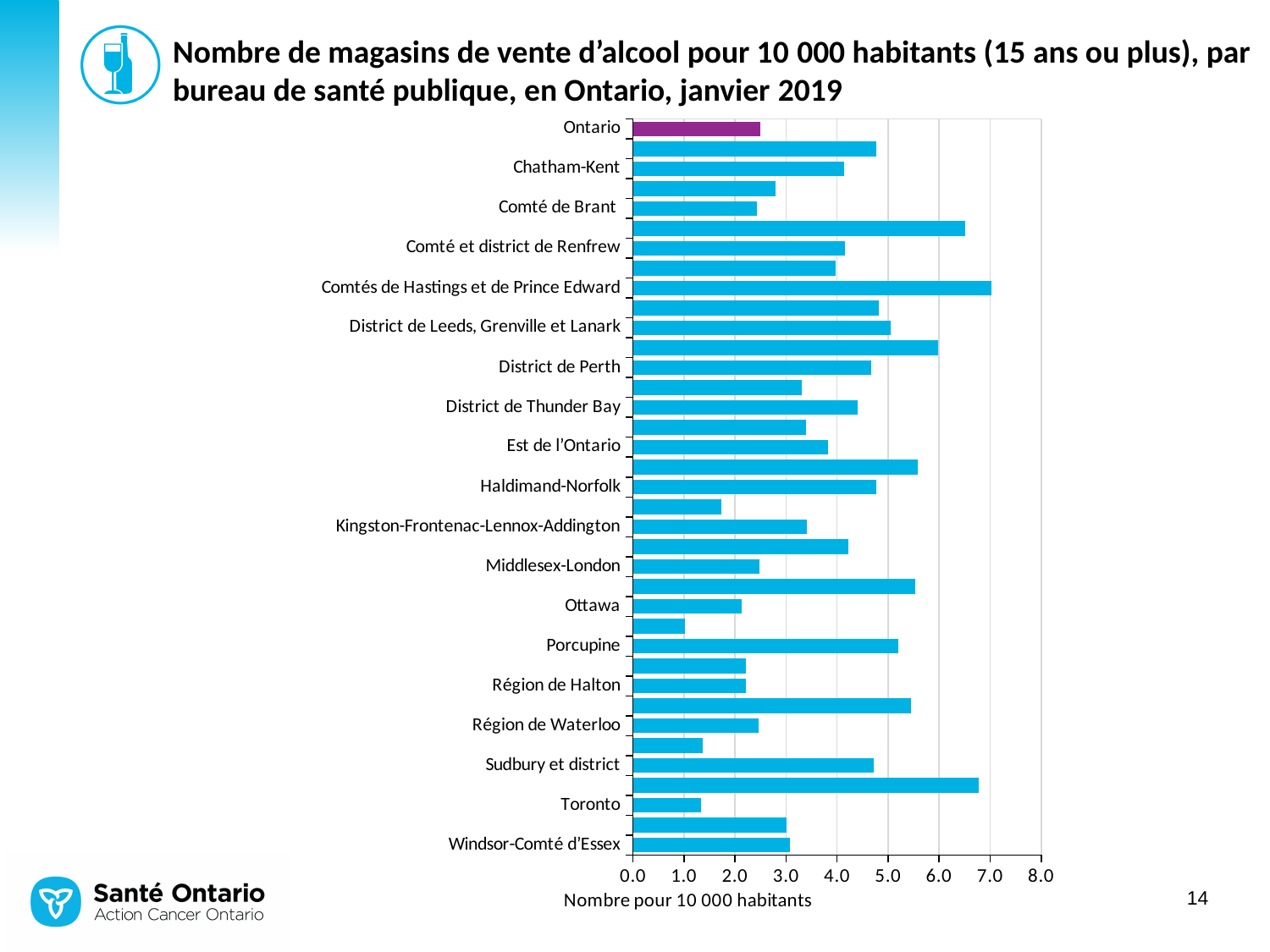
Is the value for Ottawa greater or less than 3.0? less Which has the larger value, Comtés de Hastings et de Prince Edward or Toronto? Comtés de Hastings et de Prince Edward What is the title of the horizontal axis? Nombre pour 10 000 habitants Is the value for Comtés de Hastings et de Prince Edward greater or less than 6.0? greater Is the value for Toronto greater or less than 2.0? less Among the labelled public health units, which has the highest value? Comtés de Hastings et de Prince Edward What kind of chart is shown on the slide? bar chart Which has the larger value, Ontario or District de Perth? District de Perth Which has the larger value, Porcupine or Ottawa? Porcupine